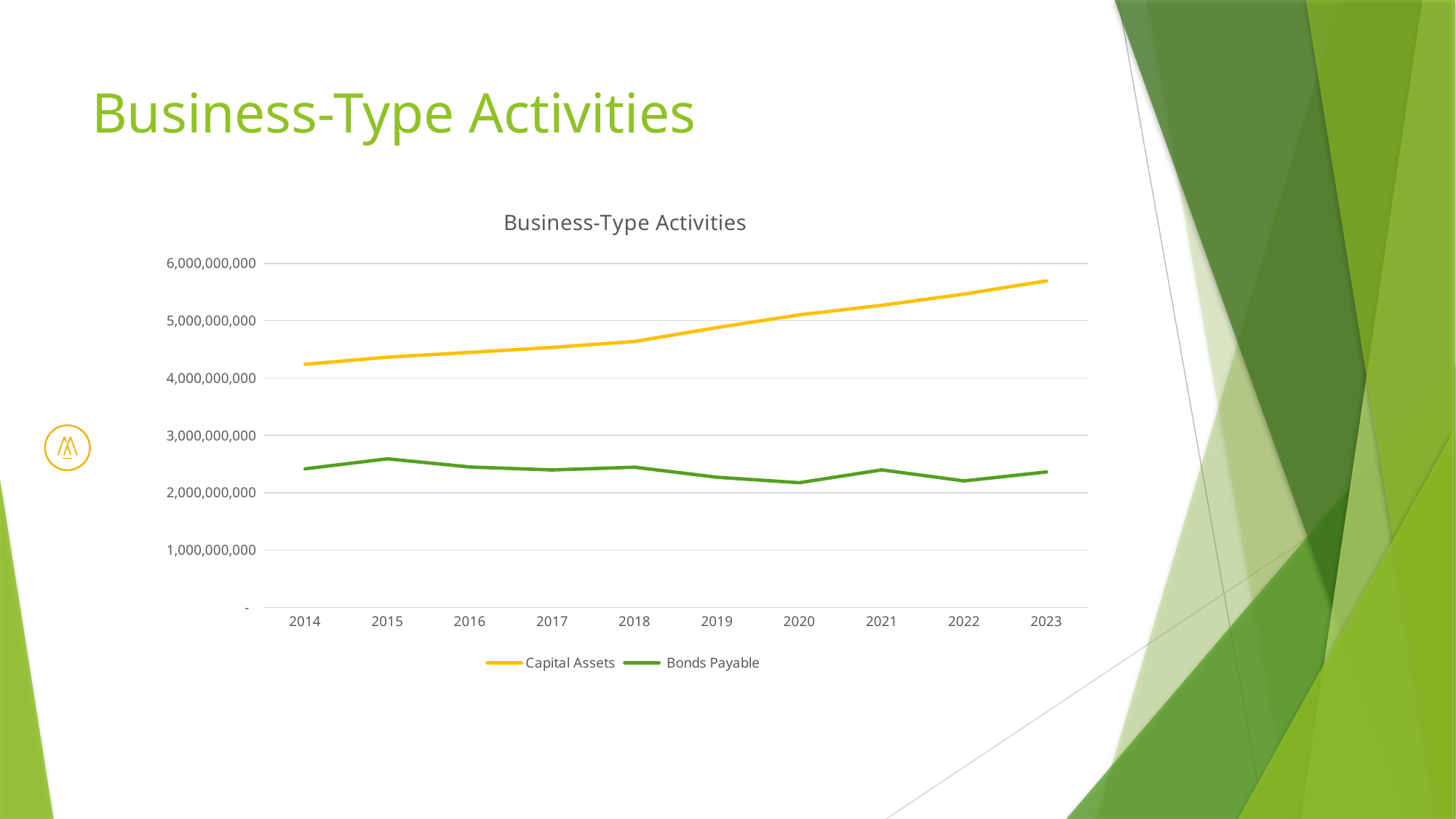
In which year is Bonds Payable highest? 2015 In 2023, which series has the larger value, Capital Assets or Bonds Payable? Capital Assets In which year is Capital Assets lowest? 2014 How many series does the legend list? 2 What is the title of the chart? Business-Type Activities In which year is Capital Assets highest? 2023 Does the Capital Assets line rise or fall from 2014 to 2023? rises Is the value for Capital Assets in 2018 greater or less than 5,000,000,000? less Is the value for Capital Assets in 2023 greater or less than 5,000,000,000? greater How many years are plotted along the x axis? 10 Is the value for Bonds Payable in 2020 greater or less than 2,000,000,000? greater What kind of chart is shown on the slide? line chart